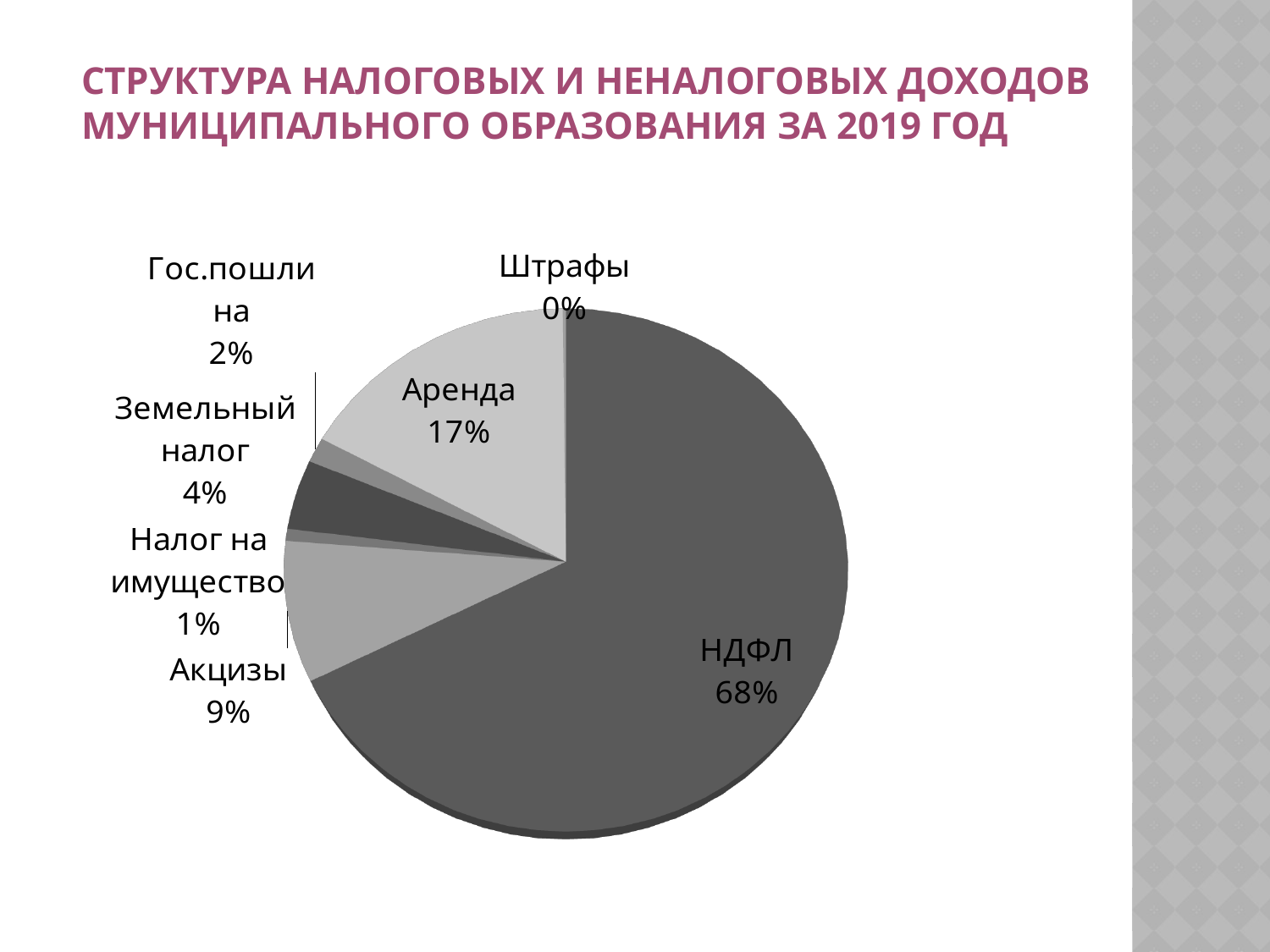
What share of the pie does Аренда account for? 17% What kind of chart is shown on the slide? pie chart What is the value shown for Акцизы? 9% Which is larger, Акцизы or Земельный налог? Акцизы Which category has the smallest slice of the pie? Штрафы What is the value shown for Земельный налог? 4% Which category has the largest slice of the pie? НДФЛ What is the value shown for Гос.пошлина? 2% What share of the pie does НДФЛ account for? 68% How many slices does the pie chart have? 7 What is the difference in percentage points between НДФЛ and Аренда? 51 What is the value shown for Штрафы? 0%